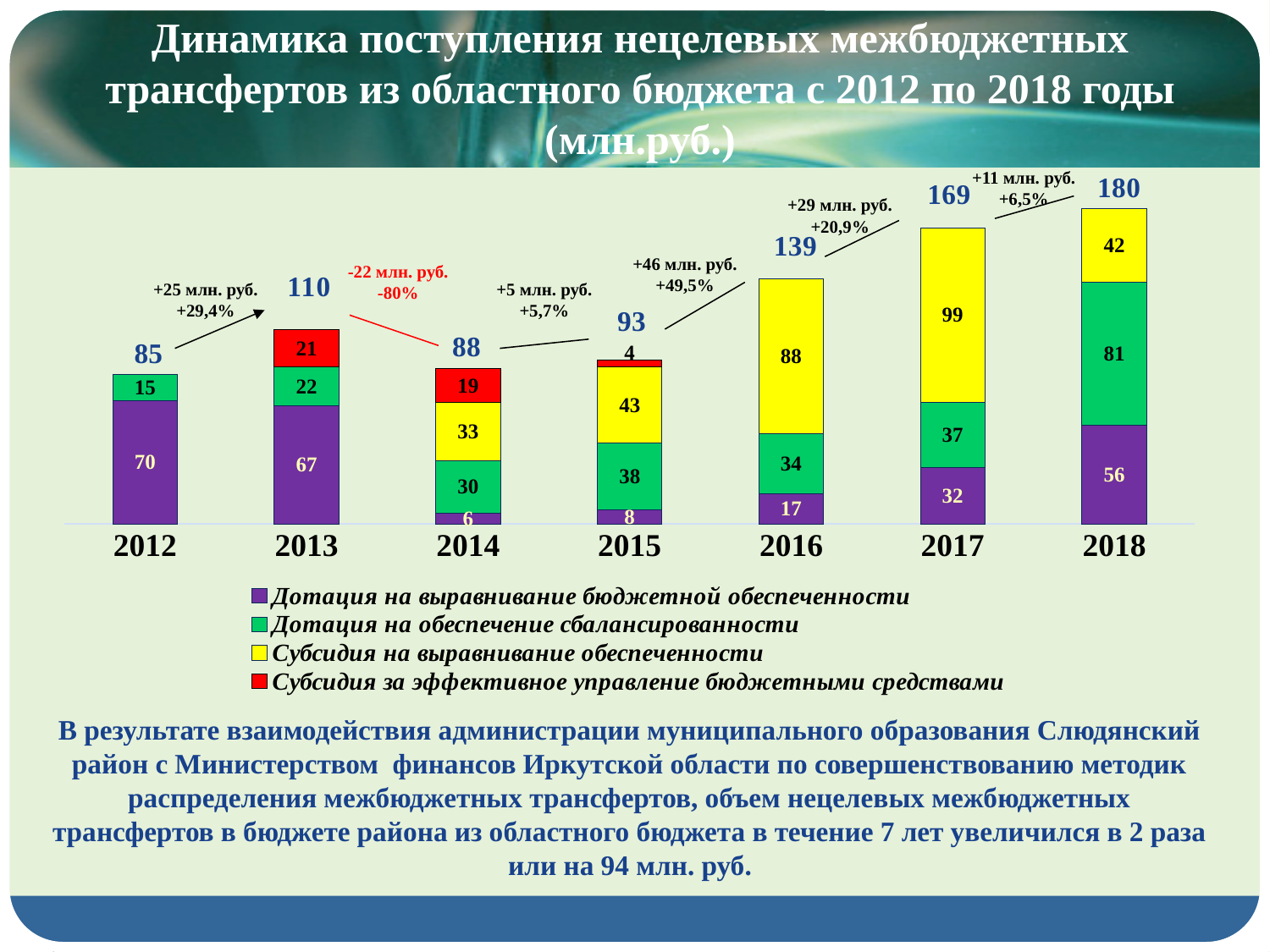
Do the total values rise or fall from 2014 to 2018? rise What is the total value of the bar for 2018? 180 What type of chart is shown on the slide? stacked bar chart What is the value of 'Субсидия за эффективное управление бюджетными средствами' in 2013? 21 What is the value of 'Дотация на выравнивание бюджетной обеспеченности' in 2012? 70 Which year has the lowest total value? 2012 Which is larger: the value of 'Дотация на обеспечение сбалансированности' in 2018 or in 2017? 2018 What is the value of 'Субсидия на выравнивание обеспеченности' in 2017? 99 How many years (categories) are shown on the x axis of the chart? 7 How many series does the chart legend list? 4 Which year has the highest total value? 2018 What is the difference between the total for 2016 and the total for 2015? 46